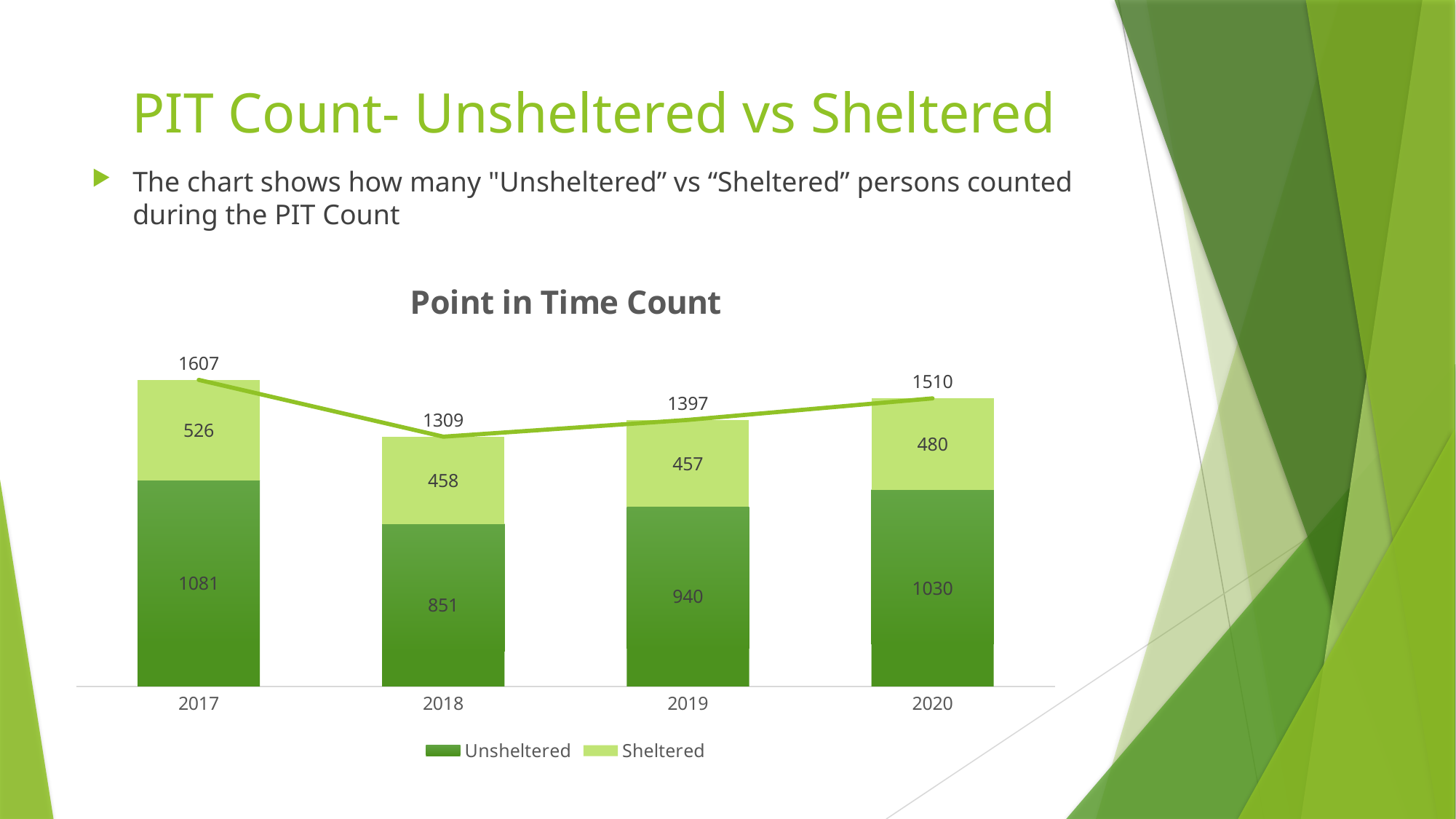
Which year has the highest Unsheltered value? 2017 What is the difference between the Unsheltered values for 2020 and 2018? 179 How many years are shown on the x axis? 4 How many series does the legend list? 2 What is the Unsheltered value for 2017? 1081 Which is larger, the Sheltered value for 2017 or for 2020? 2017 What is the Sheltered value for 2019? 457 Which year has the lowest Sheltered value? 2019 What is the title of the chart? Point in Time Count What kind of chart is this? A combination chart: stacked bar chart with a line showing the totals Does the total count rise or fall from 2017 to 2018? Fall What is the total Point in Time Count for 2018? 1309